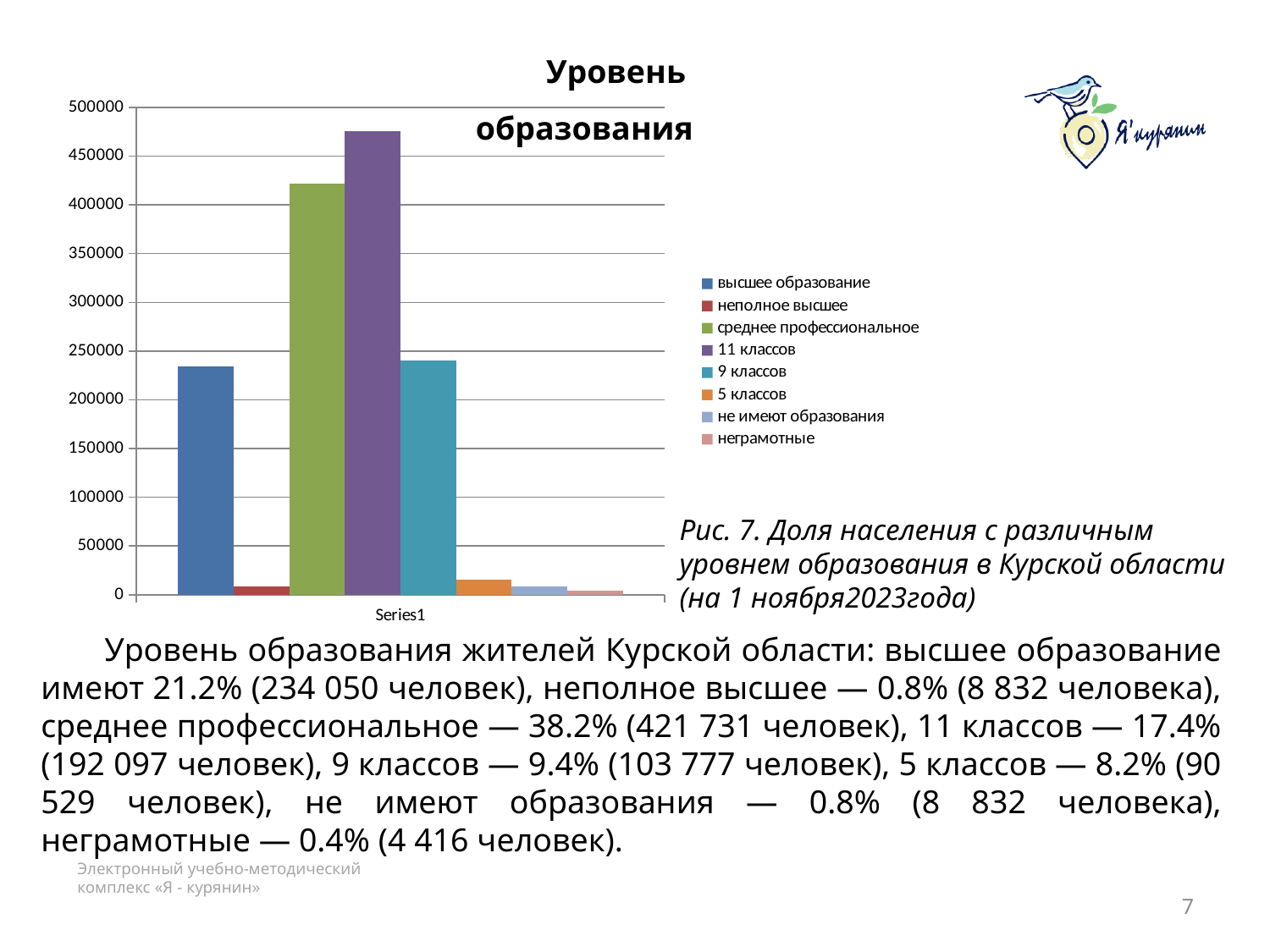
Is the value for 11 классов greater or less than 450000? greater What kind of chart is shown on the slide? bar chart What is the title of the chart? Уровень образования Is the value for среднее профессиональное greater or less than 400000? greater Which is larger, the bar for среднее профессиональное or the bar for высшее образование? среднее профессиональное How many bars are plotted in the chart? 8 How many entries does the chart legend list? 8 Which category has the shortest bar in the chart? неграмотные Which is larger, the bar for 9 классов or the bar for 5 классов? 9 классов Is the value for высшее образование greater or less than 200000? greater Which category has the tallest bar in the chart? 11 классов